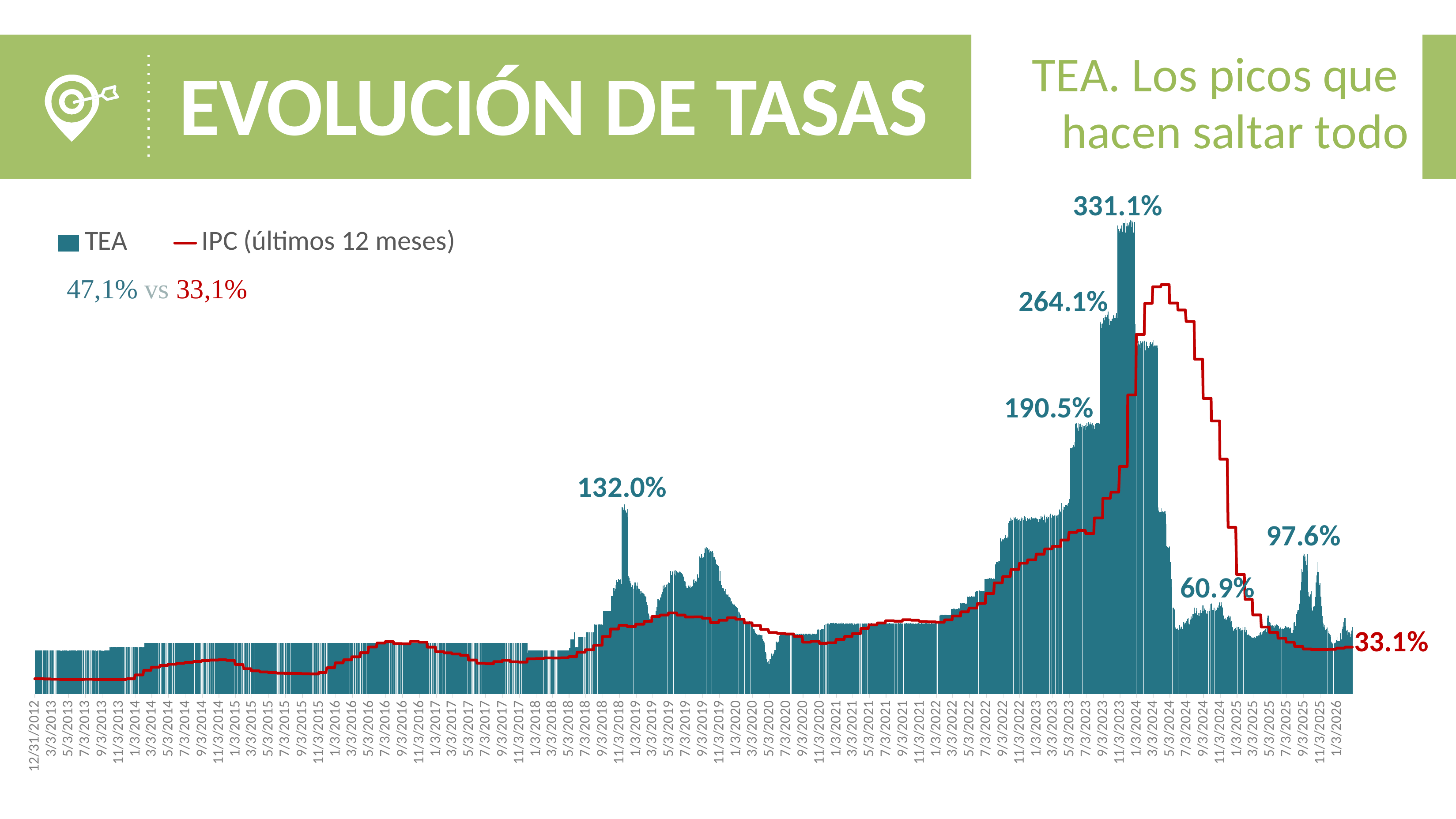
How many series does the legend list? 2 Which labelled TEA value is larger, 190.5% or 132.0%? 190.5% What is the lowest TEA value labelled on the chart? 60.9% What TEA value is labelled at the peak in late 2025? 97.6% What is the highest TEA value labelled on the chart? 331.1% What are the two legend entries of the chart? TEA and IPC (últimos 12 meses) What TEA value is labelled at the spike around late 2018? 132.0% What is the difference between the labelled TEA peaks of 331.1% and 264.1%? 67.0 percentage points How many TEA data labels are printed on the chart? 6 What is the final IPC (últimos 12 meses) value labelled at the right end of the red line? 33.1% Does the IPC line rise or fall between early 2024 and early 2026? fall What is the difference between the labelled TEA values of 97.6% and 60.9%? 36.7 percentage points